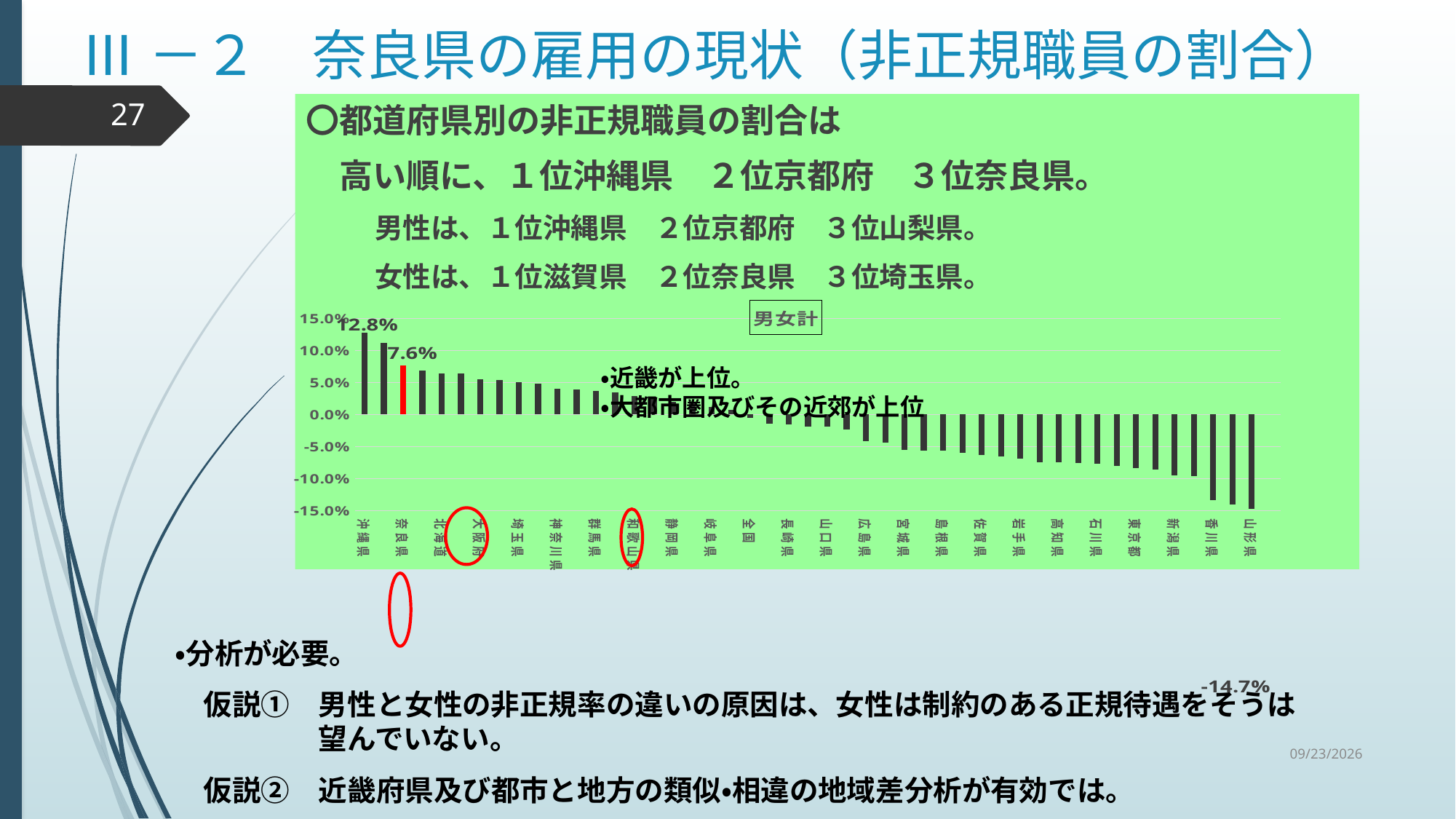
What is the difference between the values for 沖縄県 and 奈良県 in the 男女計 chart? 5.2% Is the value for 北海道 in the 男女計 chart greater or less than 10.0%? less Is the value for 東京都 in the 男女計 chart greater or less than -5.0%? less What is the value for 沖縄県 in the 男女計 chart? 12.8% What is the value for 山形県 in the 男女計 chart? -14.7% What kind of chart is shown on the slide? bar chart Which category has the lowest value in the 男女計 chart? 山形県 What is the value for 奈良県 in the 男女計 chart? 7.6% Which category has the highest value in the 男女計 chart? 沖縄県 Which is larger in the 男女計 chart, the value for 大阪府 or the value for 東京都? 大阪府 Which is larger in the 男女計 chart, the value for 沖縄県 or the value for 奈良県? 沖縄県 Do the values in the 男女計 chart rise or fall from left to right along the x axis? fall